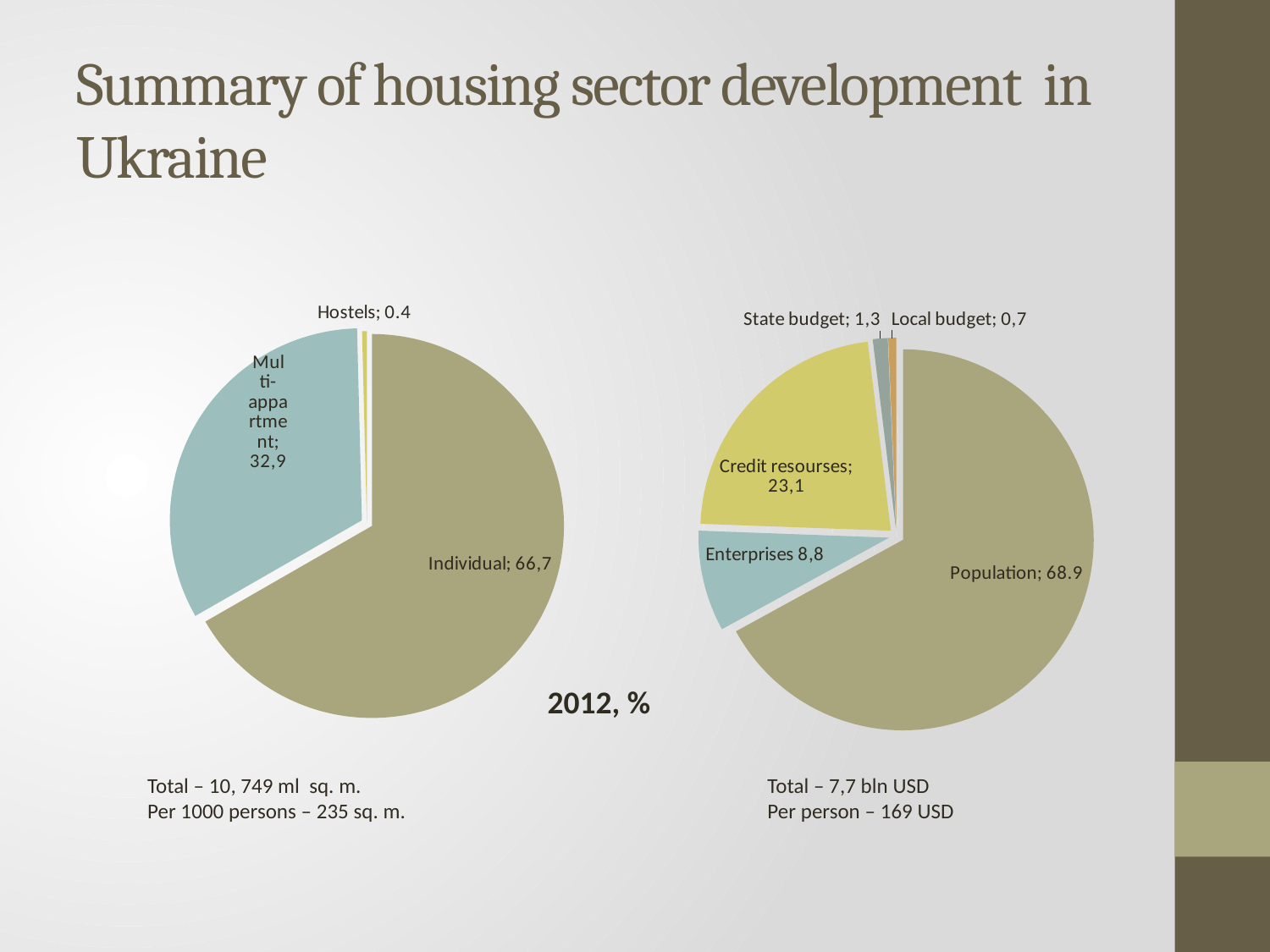
On the left pie chart, what is the value for Individual? 66,7 On the left pie chart, what is the value for Hostels? 0.4 On the right pie chart, which category has the largest slice? Population On the left pie chart, which category has the largest slice? Individual On the right pie chart, what is the value for Enterprises? 8,8 On the right pie chart, what is the value for Credit resourses? 23,1 On the left pie chart, how many slices are there? 3 On the right pie chart, what is the value for Local budget? 0,7 On the left pie chart, which category has the smallest slice? Hostels What type of chart is used on the left side of the slide? Pie chart On the right pie chart, which is larger, State budget or Local budget? State budget On the right pie chart, how many slices are there? 5